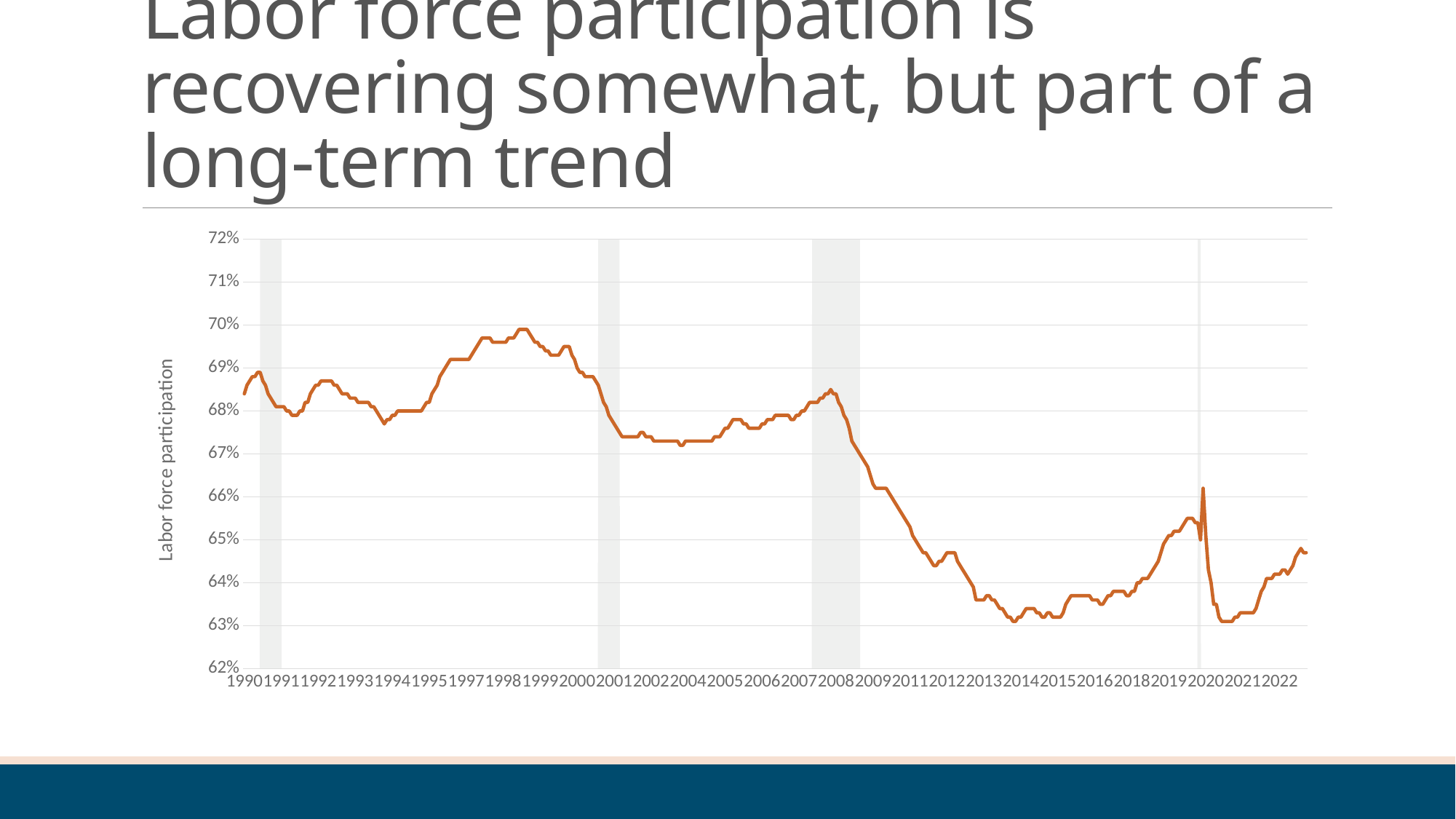
Overall, is labor force participation lower or higher in 2022 than in 1990? lower Is the labor force participation value in 2014 greater or less than 64%? less Does labor force participation rise or fall between 2014 and 2019? rise Is the peak labor force participation value around 1999 greater or less than 69%? greater Is the labor force participation value in 2004 greater or less than 68%? less What is the highest value shown on the vertical axis? 72% Does labor force participation rise or fall between 2008 and 2014? fall What kind of chart is shown on the slide? line chart What is the label on the vertical axis of the chart? Labor force participation